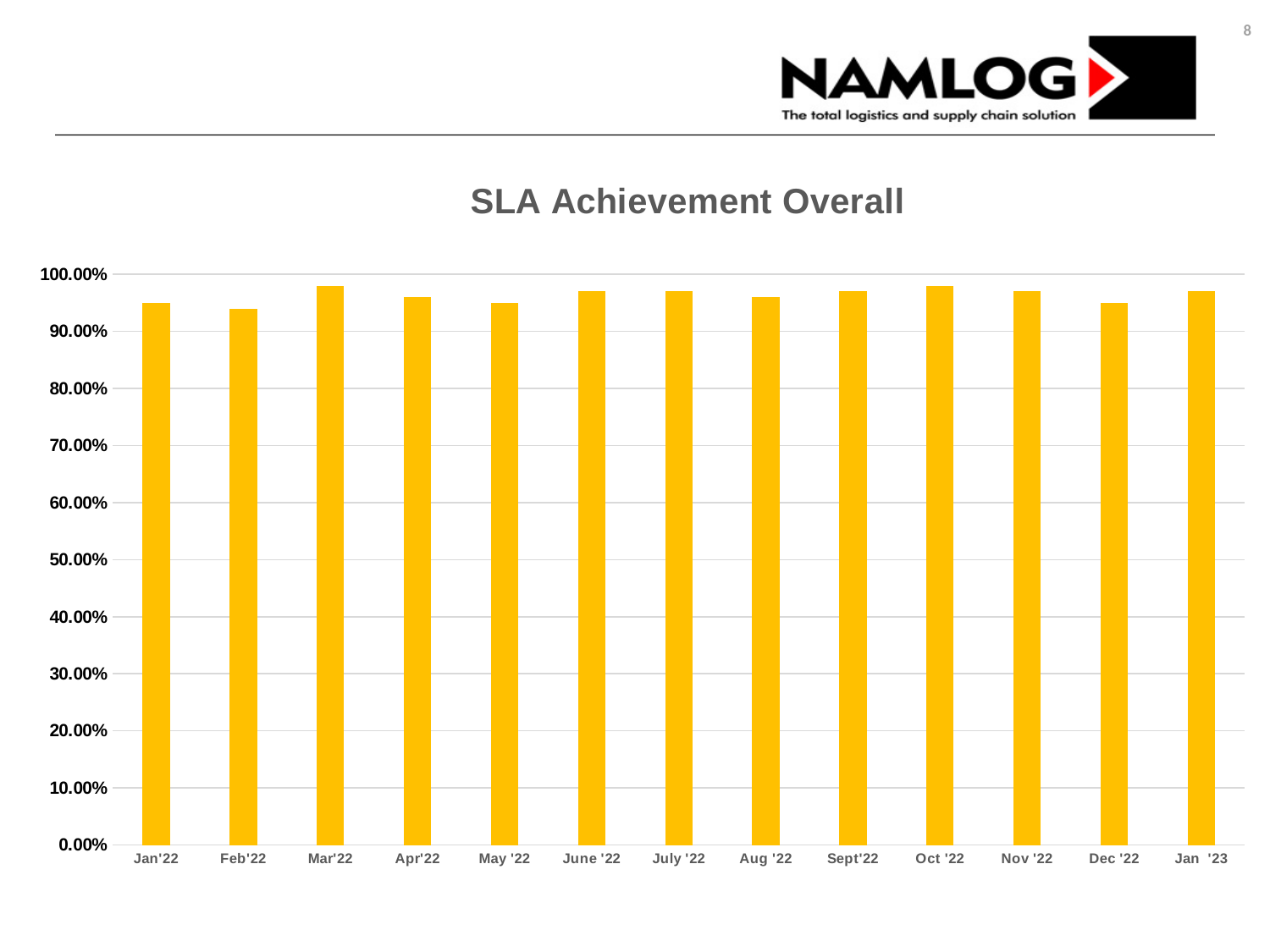
Is the value for Mar'22 greater or less than 100.00%? less Is the value for Jan '23 greater or less than 90.00%? greater What kind of chart is shown on the slide? bar chart Is the value for Feb'22 greater or less than 90.00%? greater What is the first month shown on the x axis? Jan'22 How many months are plotted on the x axis? 13 What is the title of the chart? SLA Achievement Overall Which is larger, the value for Oct '22 or the value for Dec '22? Oct '22 Which is larger, the value for Mar'22 or the value for Feb'22? Mar'22 Which month has the lowest SLA achievement? Feb'22